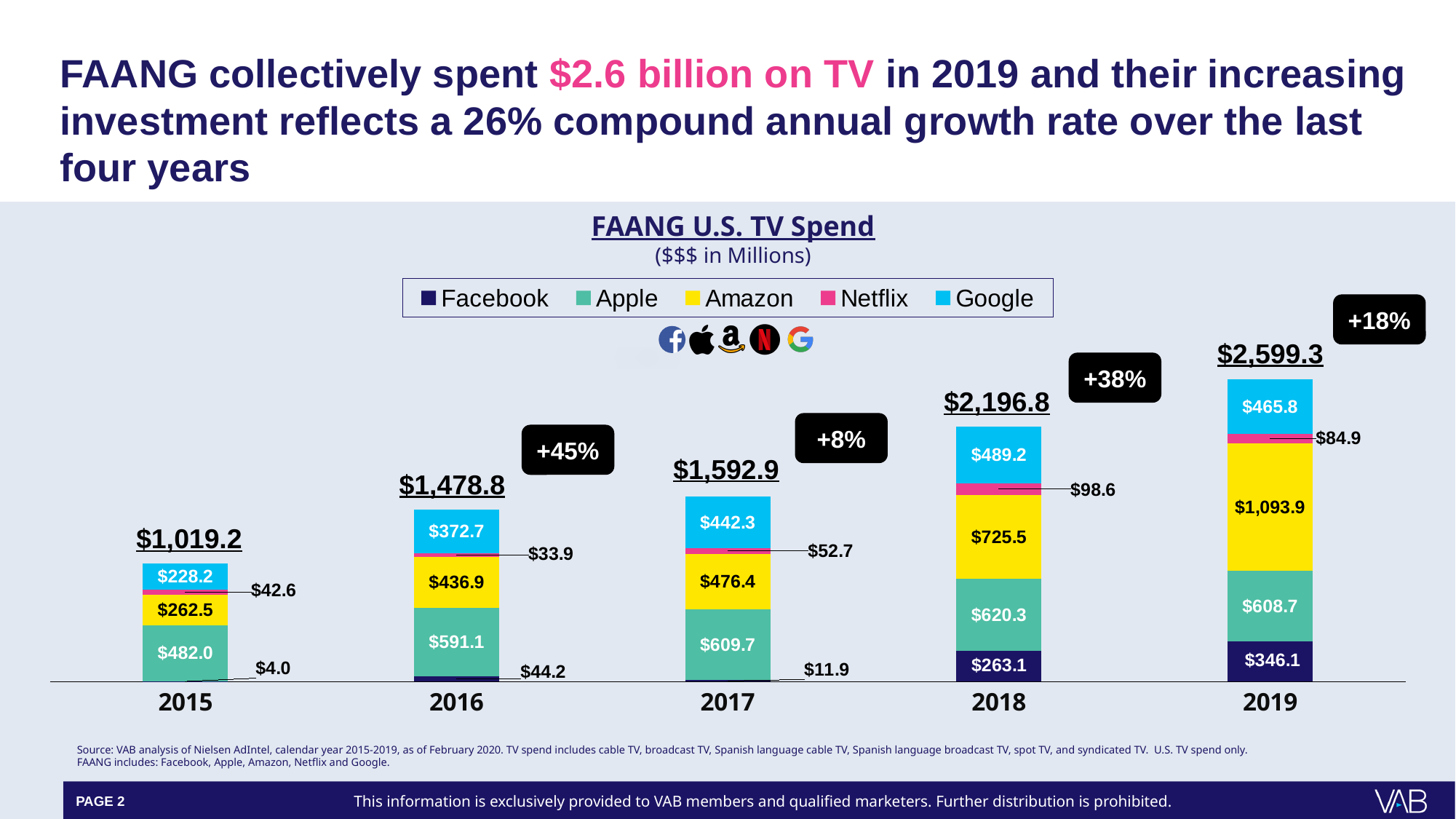
What was Netflix's U.S. TV spend in 2018? $98.6 How many years are shown on the x axis of the chart? 5 What type of chart is used to show FAANG U.S. TV Spend? Stacked bar chart How many series does the chart legend list? 5 What was Amazon's U.S. TV spend in 2019? $1,093.9 Which year has the highest total FAANG U.S. TV spend? 2019 What was Google's U.S. TV spend in 2017? $442.3 What was Apple's U.S. TV spend in 2015? $482.0 Which was larger in 2016, Apple's or Amazon's U.S. TV spend? Apple What is the total FAANG U.S. TV spend shown for 2018? $2,196.8 What is the difference between Facebook's U.S. TV spend in 2019 and in 2018? $83.0 Which year has the lowest total FAANG U.S. TV spend? 2015